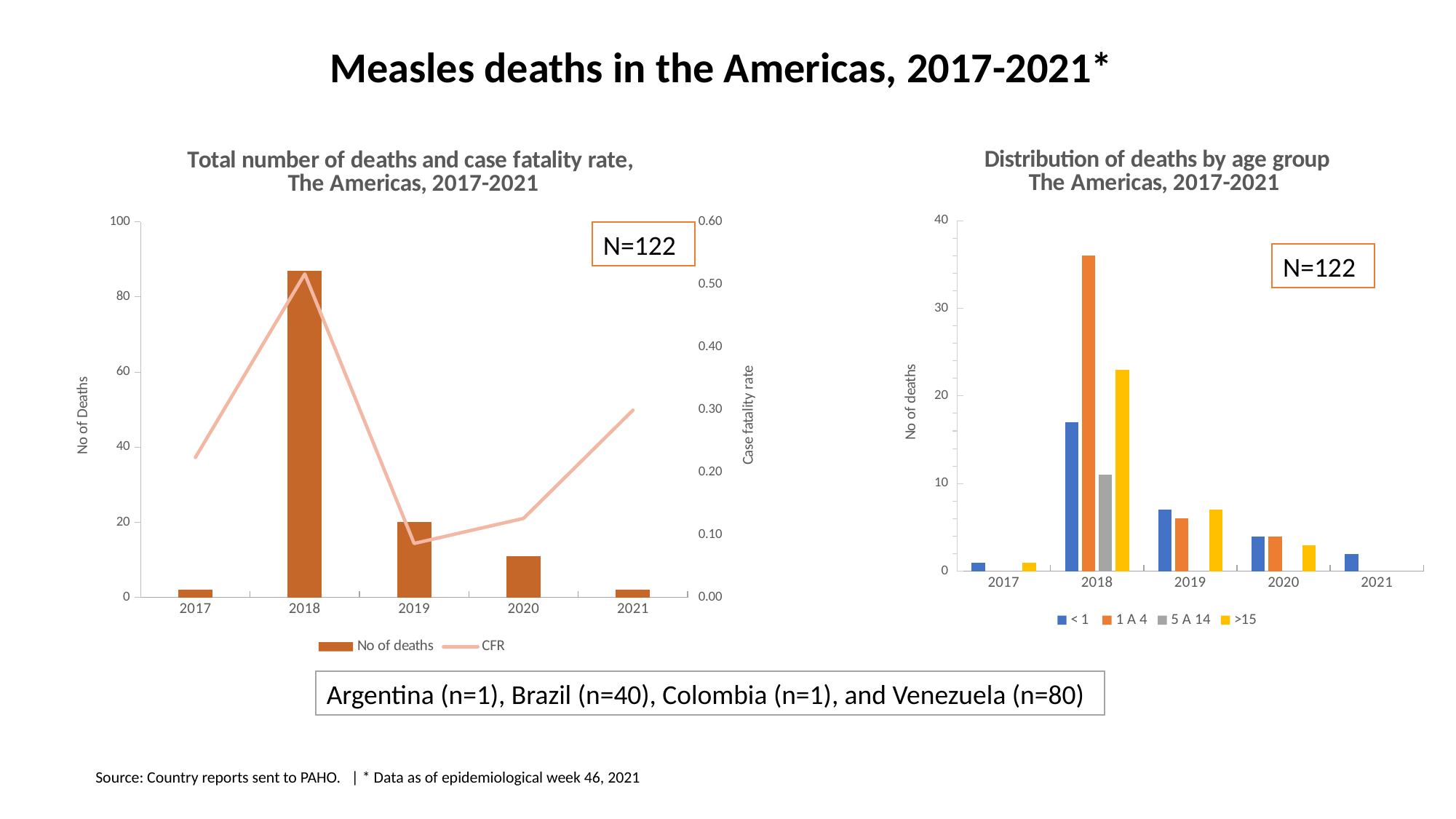
In the chart 'Total number of deaths and case fatality rate', how many years are shown on the x axis? 5 In the chart 'Total number of deaths and case fatality rate', which year has the highest number of deaths? 2018 In the chart 'Total number of deaths and case fatality rate', do the number of deaths rise or fall from 2018 to 2021? fall In the chart 'Distribution of deaths by age group', how many age groups does the legend list? 4 In the chart 'Total number of deaths and case fatality rate', is the case fatality rate in 2018 greater or less than 0.40? greater In the chart 'Total number of deaths and case fatality rate', is the number of deaths in 2018 greater or less than 80? greater In the chart 'Total number of deaths and case fatality rate', is the number of deaths in 2019 greater or less than 40? less In the chart 'Total number of deaths and case fatality rate', how many series does the legend list? 2 In the chart 'Distribution of deaths by age group', which age group has the highest number of deaths in 2018? 1 A 4 What kind of chart is 'Distribution of deaths by age group'? bar chart In the chart 'Distribution of deaths by age group', which is larger in 2018: the < 1 age group or the 5 A 14 age group? < 1